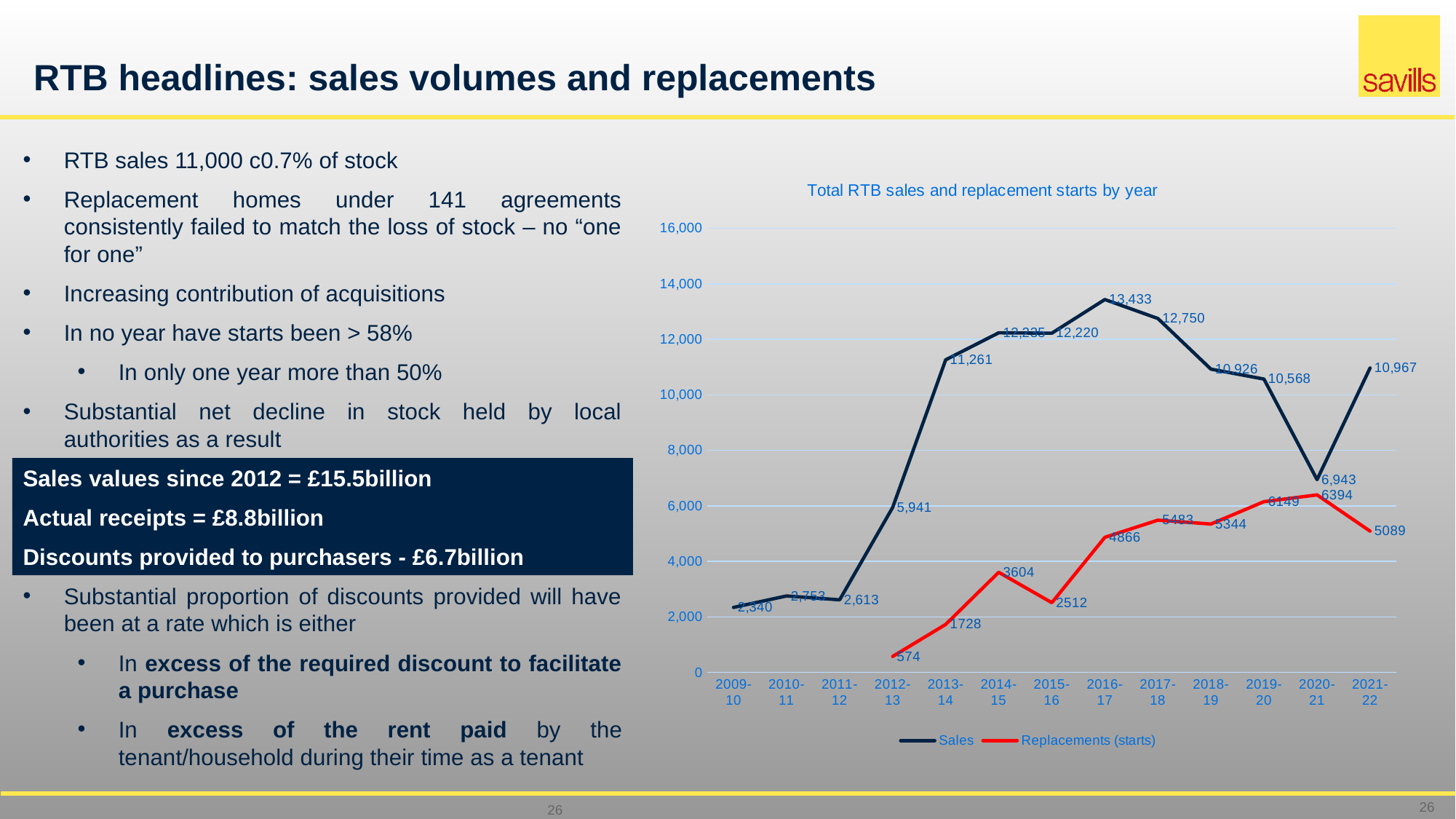
What is the difference between Sales in 2016-17 and Sales in 2020-21? 6,490 In which year were Sales highest? 2016-17 What is the Sales value for 2021-22? 10,967 In 2019-20, which is larger: Sales or Replacements (starts)? Sales In which year were Replacements (starts) highest? 2020-21 What is the Replacements (starts) value for 2012-13? 574 How many series does the chart legend list? 2 Is the Sales value for 2013-14 greater or less than 10,000? greater What kind of chart is shown on the slide? Line chart What colour is the Replacements (starts) line in the chart? Red How many years are shown on the x axis of the chart? 13 In which year were Sales lowest? 2009-10